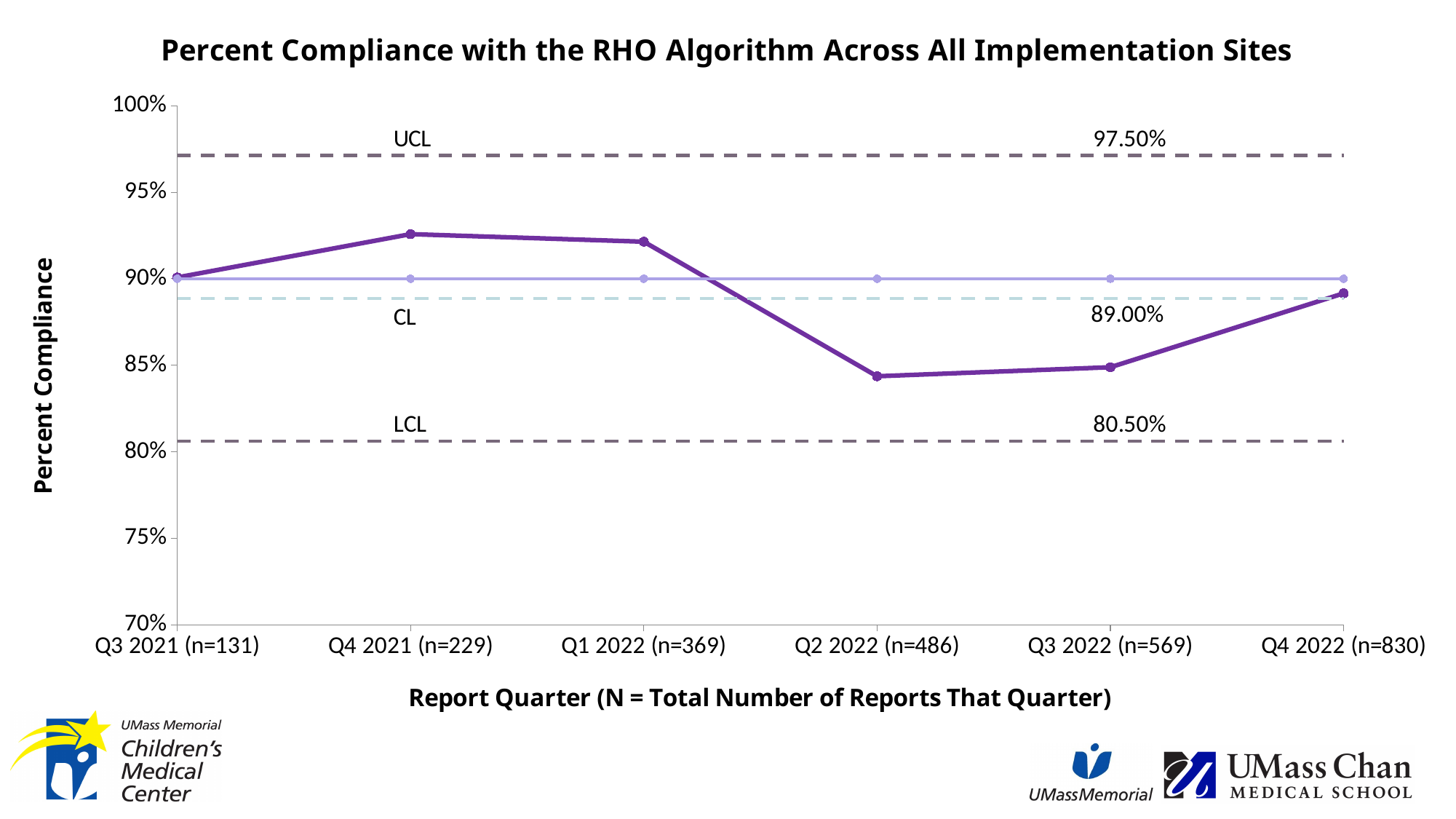
How many report quarters are plotted on the x axis? 6 What is the value of the UCL line? 97.50% Which report quarter has the highest percent compliance? Q4 2021 (n=229) Which has the higher percent compliance, Q4 2021 or Q2 2022? Q4 2021 What is the value of the LCL line? 80.50% Does percent compliance rise or fall from Q1 2022 to Q2 2022? fall What is the difference between the UCL and the LCL values? 17.00% What is the value of the CL line? 89.00% What is the title of the chart? Percent Compliance with the RHO Algorithm Across All Implementation Sites Is the percent compliance for Q2 2022 greater or less than 85%? less What kind of chart is shown on the slide? line chart Is the percent compliance for Q4 2021 greater or less than 90%? greater